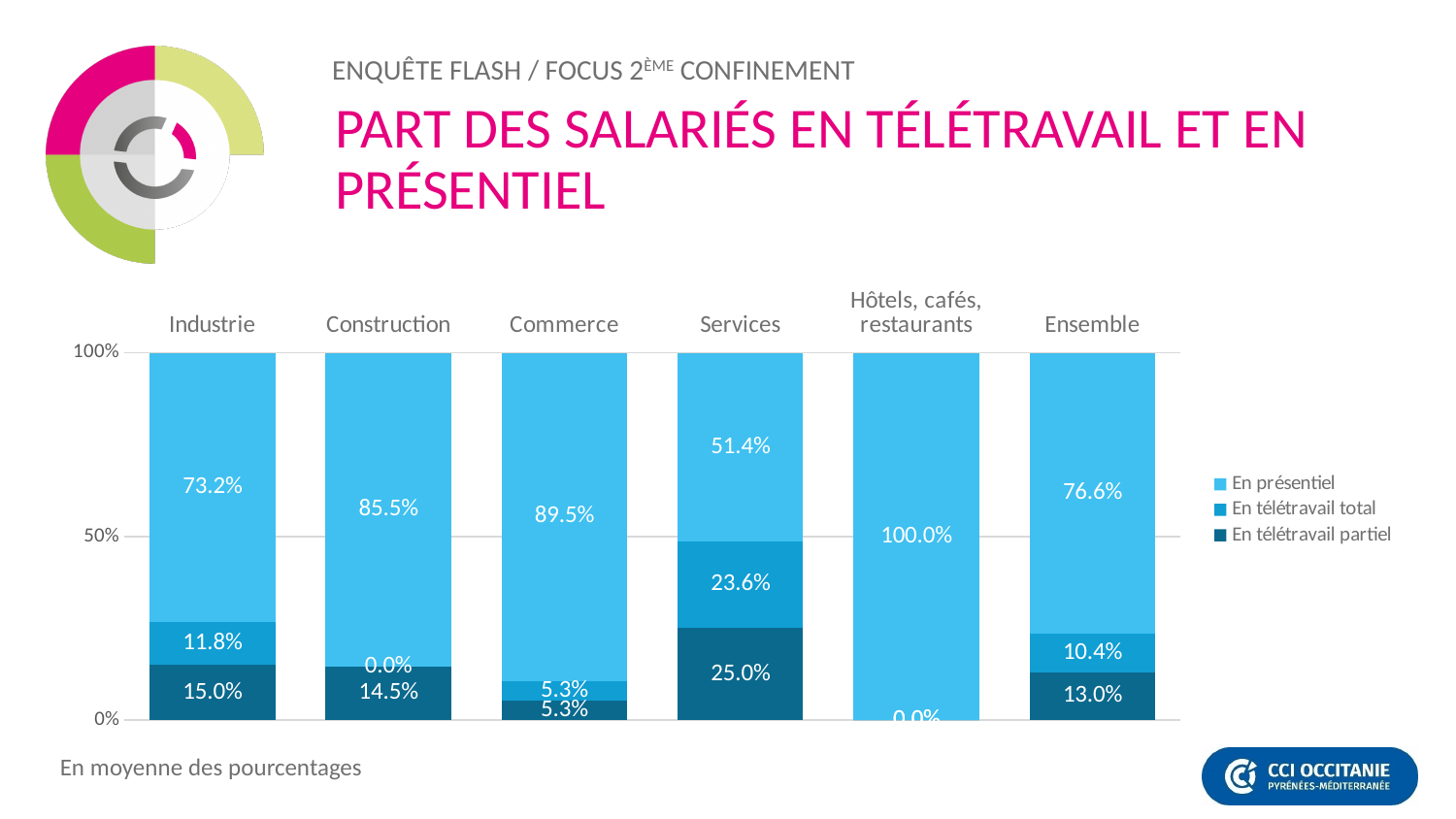
Which category has the lowest 'En présentiel' value? Services How many series does the legend list? 3 What type of chart is shown on the slide? Stacked bar chart Which is larger, the 'En télétravail partiel' value for Industrie or for Construction? Industrie How many categories are shown on the x axis? 6 What is the value of 'En présentiel' for Industrie? 73.2% What is the title of the chart? Part des salariés en télétravail et en présentiel Which category has the highest 'En télétravail total' value? Services What is the value of 'En télétravail total' for Ensemble? 10.4% What is the difference between the 'En présentiel' values for Commerce and Construction? 4.0% What is the value of 'En présentiel' for Hôtels, cafés, restaurants? 100.0% What is the value of 'En télétravail partiel' for Services? 25.0%